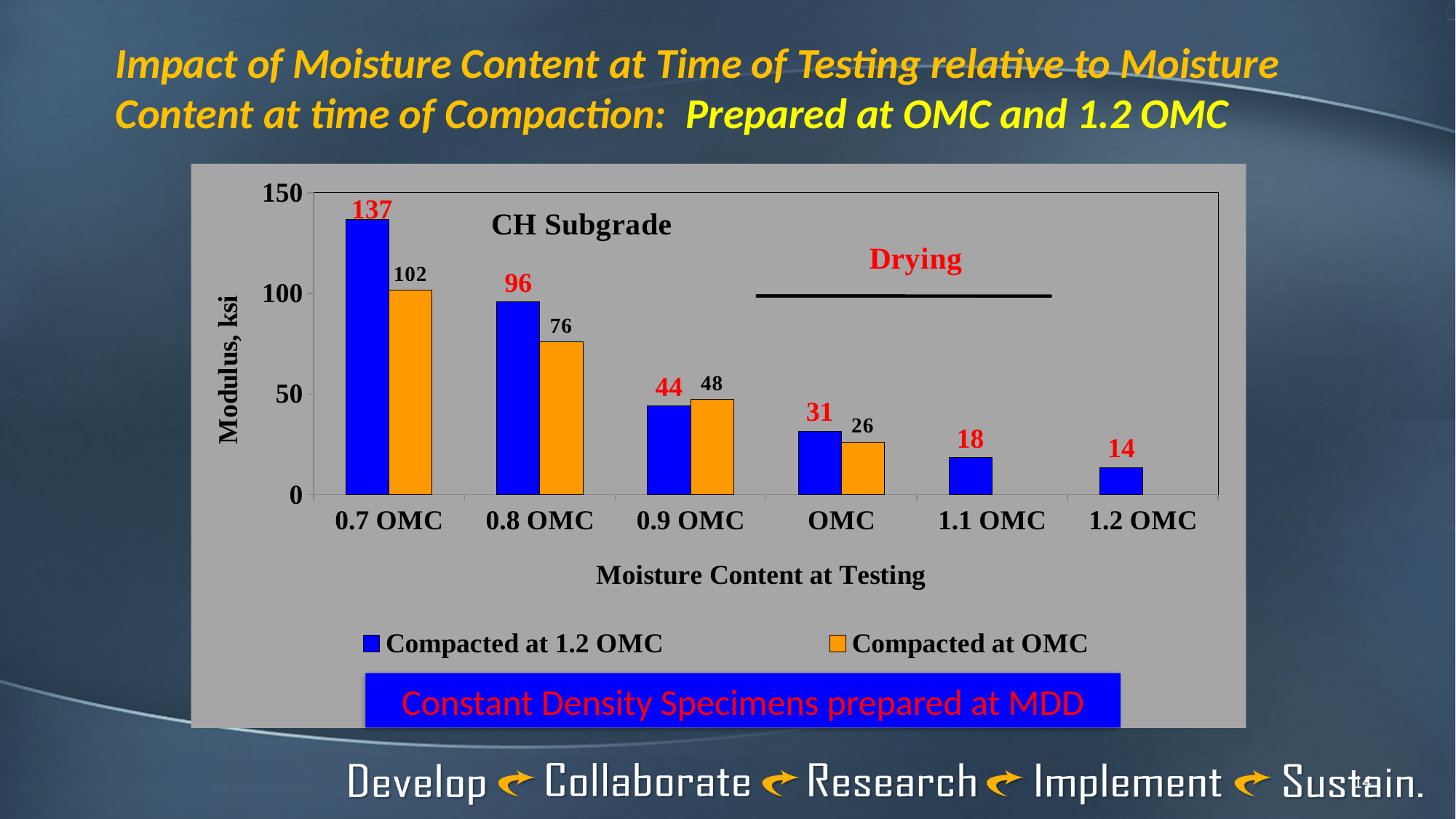
What is the y-axis label of the chart? Modulus, ksi What is the modulus for Compacted at OMC at 0.8 OMC moisture content at testing? 76 What is the modulus for Compacted at 1.2 OMC at 1.2 OMC moisture content at testing? 14 How many moisture content categories are shown on the x axis? 6 What is the difference between the Compacted at 1.2 OMC and Compacted at OMC values at 0.7 OMC? 35 Does the modulus for Compacted at 1.2 OMC rise or fall as moisture content at testing increases from 0.7 OMC to 1.2 OMC? Fall At 0.9 OMC, which series has the larger modulus: Compacted at 1.2 OMC or Compacted at OMC? Compacted at OMC Which moisture content at testing has the lowest modulus for the Compacted at OMC series? OMC What kind of chart is shown on the slide? Bar chart What is the modulus for Compacted at 1.2 OMC at 0.7 OMC moisture content at testing? 137 Which moisture content at testing has the highest modulus for the Compacted at 1.2 OMC series? 0.7 OMC How many series does the legend list? 2